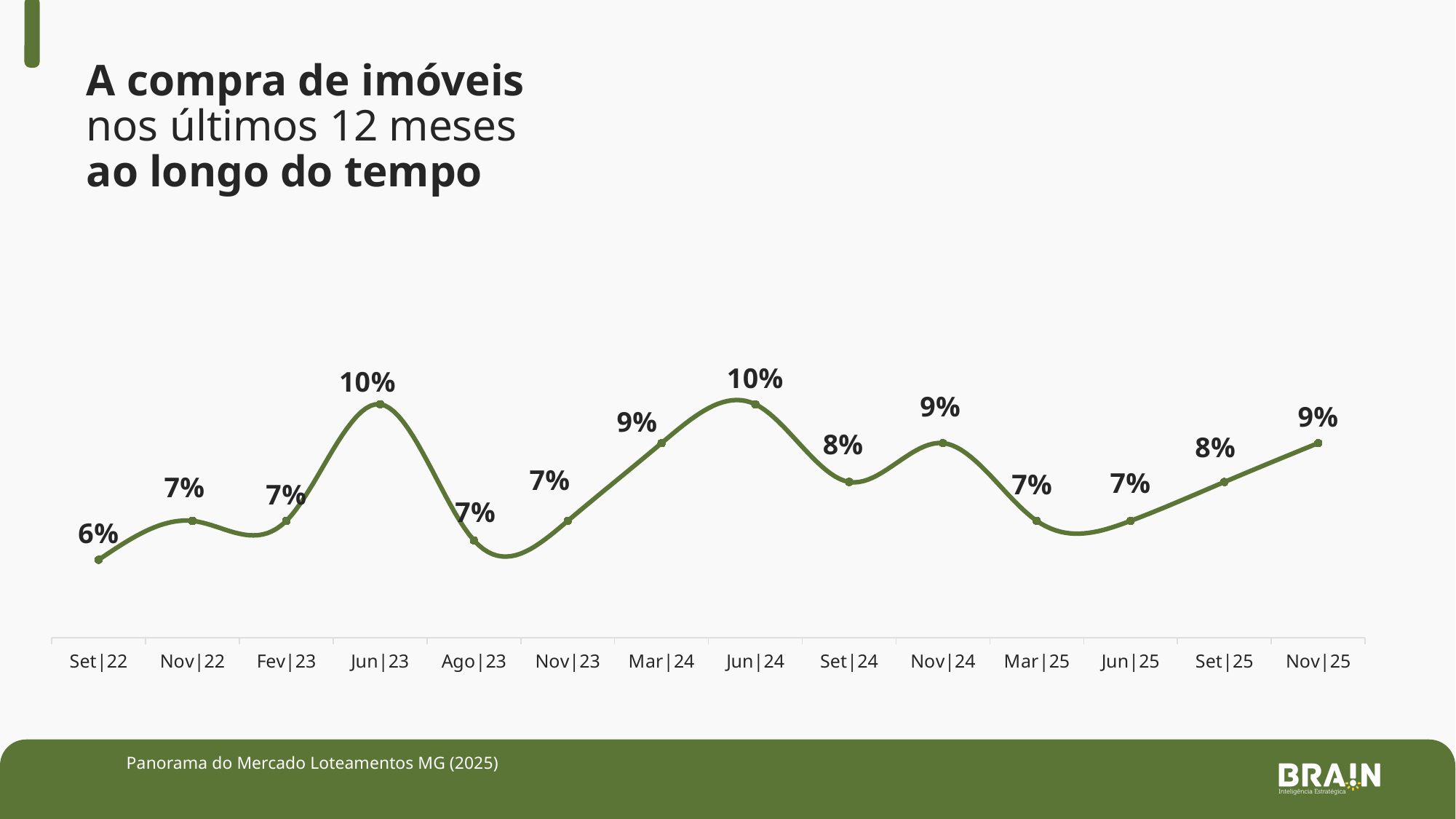
Which period has the lowest value? Set|22 What is the value for Nov|25? 9% What is the highest value shown on the chart? 10% Do the values rise or fall from Mar|25 to Nov|25? Rise What kind of chart is shown on the slide? Line chart What is the value for Set|24? 8% What is the value for Set|22? 6% What is the value for Jun|23? 10% How many data points are plotted on the chart? 14 What is the difference between the values for Jun|24 and Set|24? 2% Which is larger, the value for Mar|24 or the value for Mar|25? Mar|24 What is the source cited at the bottom of the slide? Panorama do Mercado Loteamentos MG (2025)